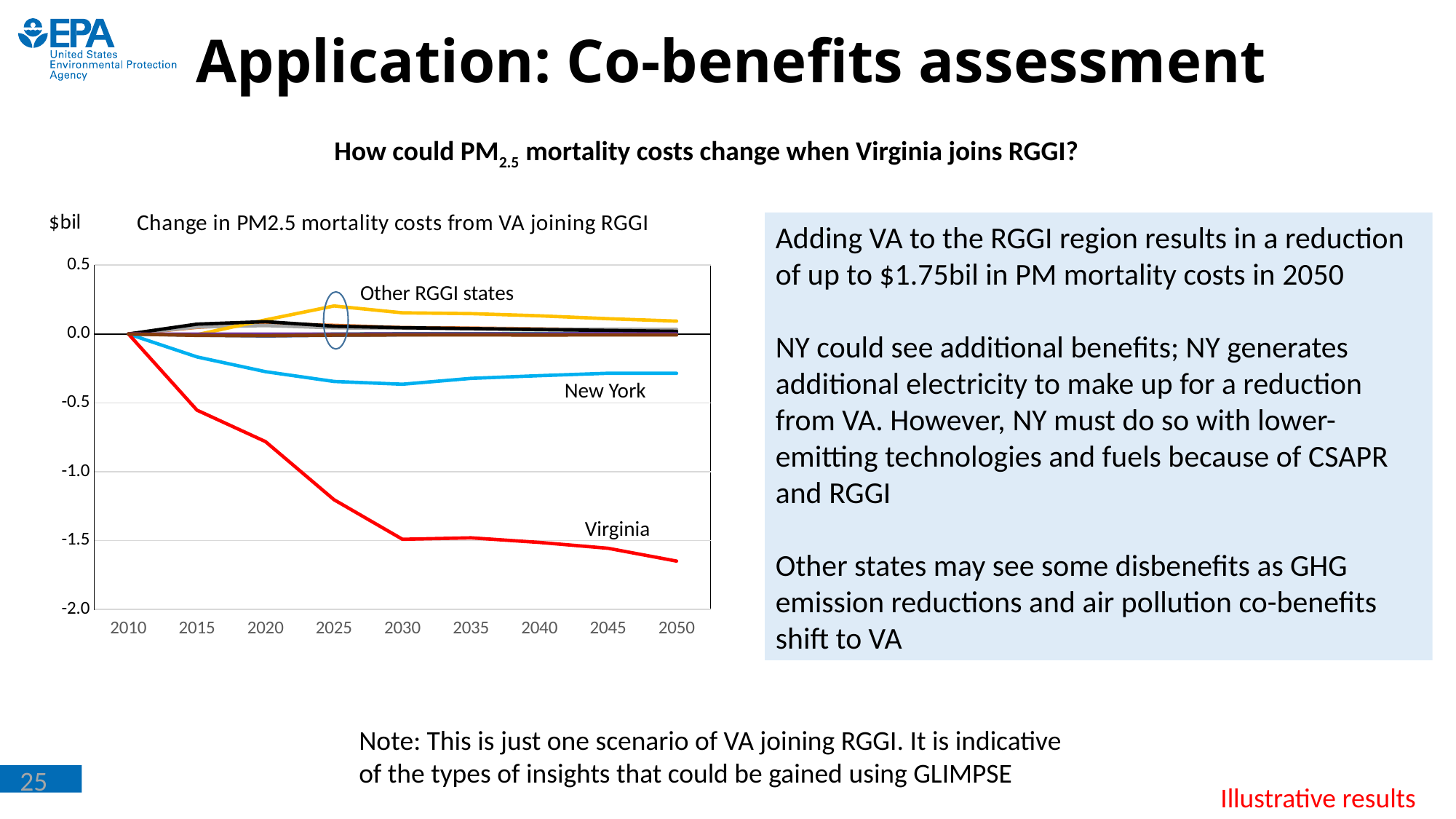
What kind of chart is shown on the slide? line chart Which labeled line has the highest value in 2050? Other RGGI states Is the value for Virginia in 2050 greater or less than -1.5? less Is the value for Virginia in 2020 greater or less than -1.0? greater In 2050, which is larger, the value for New York or the value for Virginia? New York What is the title of the chart? Change in PM2.5 mortality costs from VA joining RGGI Is the value for New York in 2030 greater or less than -0.5? greater What unit is shown on the y axis of the chart? $bil Does the Virginia line rise or fall from 2010 to 2050? fall Which labeled line has the lowest value in 2050? Virginia How many years are labeled along the x axis of the chart? 9